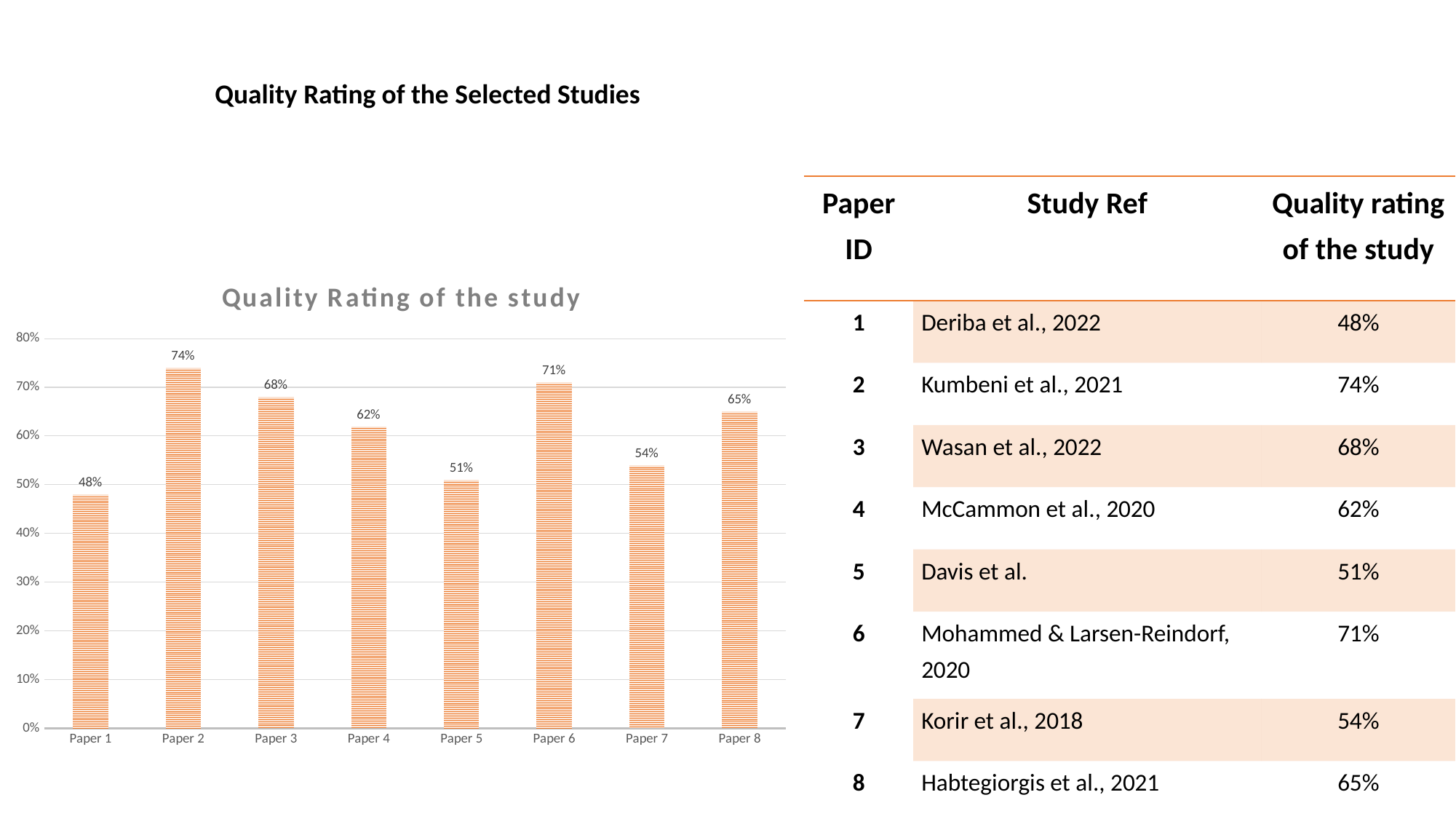
What is the difference between the quality ratings of Paper 2 and Paper 1? 26% What is the quality rating for Paper 2 in the chart? 74% How many papers are shown in the chart? 8 Which has a higher quality rating, Paper 3 or Paper 4? Paper 3 What is the title of the chart? Quality Rating of the study Is the value for Paper 7 greater or less than 60%? less What is the difference between the quality ratings of Paper 6 and Paper 7? 17% What kind of chart is shown on the slide? Bar chart What is the quality rating for Paper 5 in the chart? 51% What is the quality rating for Paper 8 in the chart? 65% Which paper has the lowest quality rating in the chart? Paper 1 Which paper has the highest quality rating in the chart? Paper 2